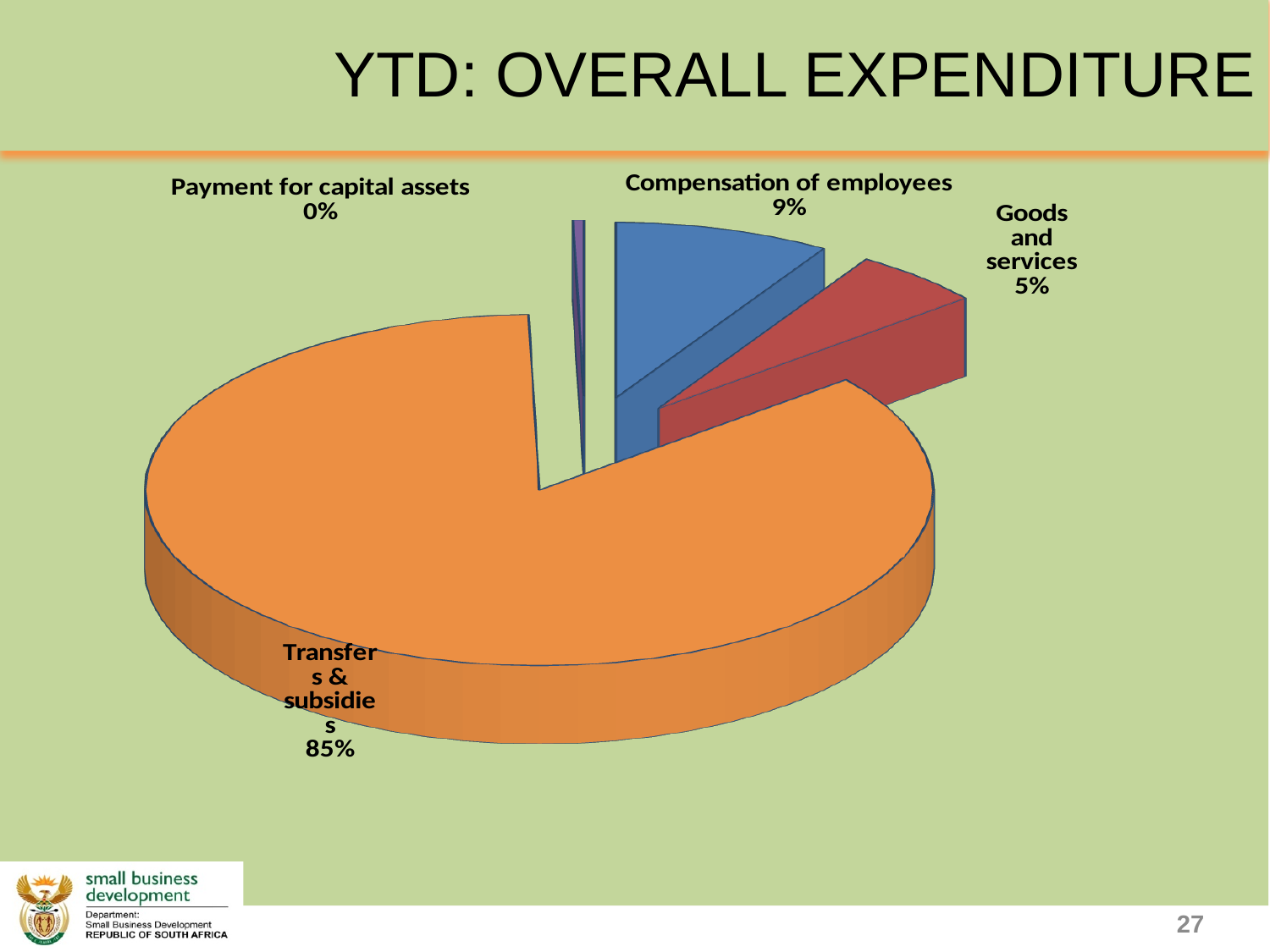
What share of overall expenditure is Compensation of employees? 9% What is the difference in percentage points between Transfers & subsidies and Compensation of employees? 76 percentage points Which category has the smallest share of overall expenditure? Payment for capital assets Which category has the largest share of overall expenditure? Transfers & subsidies What share of overall expenditure is Goods and services? 5% What is the title of the slide containing the pie chart? YTD: OVERALL EXPENDITURE What share of overall expenditure is Payment for capital assets? 0% Which is larger: Compensation of employees or Goods and services? Compensation of employees What kind of chart is shown on the slide? Pie chart How many categories are shown in the pie chart? 4 What colour is the Transfers & subsidies slice? Orange